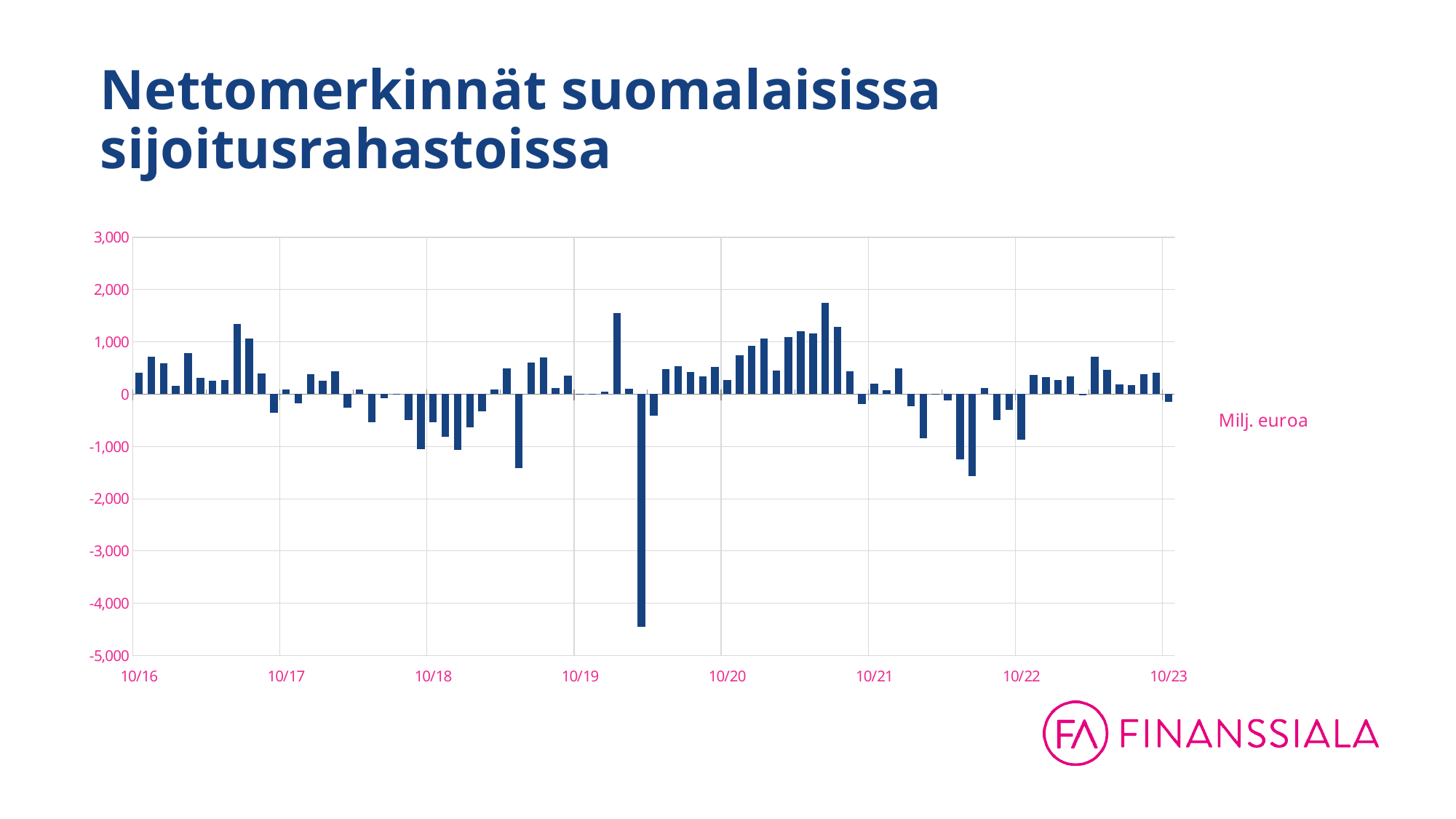
Is the value for 10/22 greater or less than 0? less What is the highest value shown on the y axis? 3,000 Is the value for 10/16 greater or less than 0? greater Is the highest bar on the chart greater or less than 1,000? greater What is the title of the chart? Nettomerkinnät suomalaisissa sijoitusrahastoissa What unit is indicated next to the chart? Milj. euroa What is the lowest value shown on the y axis? -5,000 How many date labels are shown on the x axis? 8 What kind of chart is shown on the slide? bar chart Which is larger, the value for 10/16 or the value for 10/17? 10/16